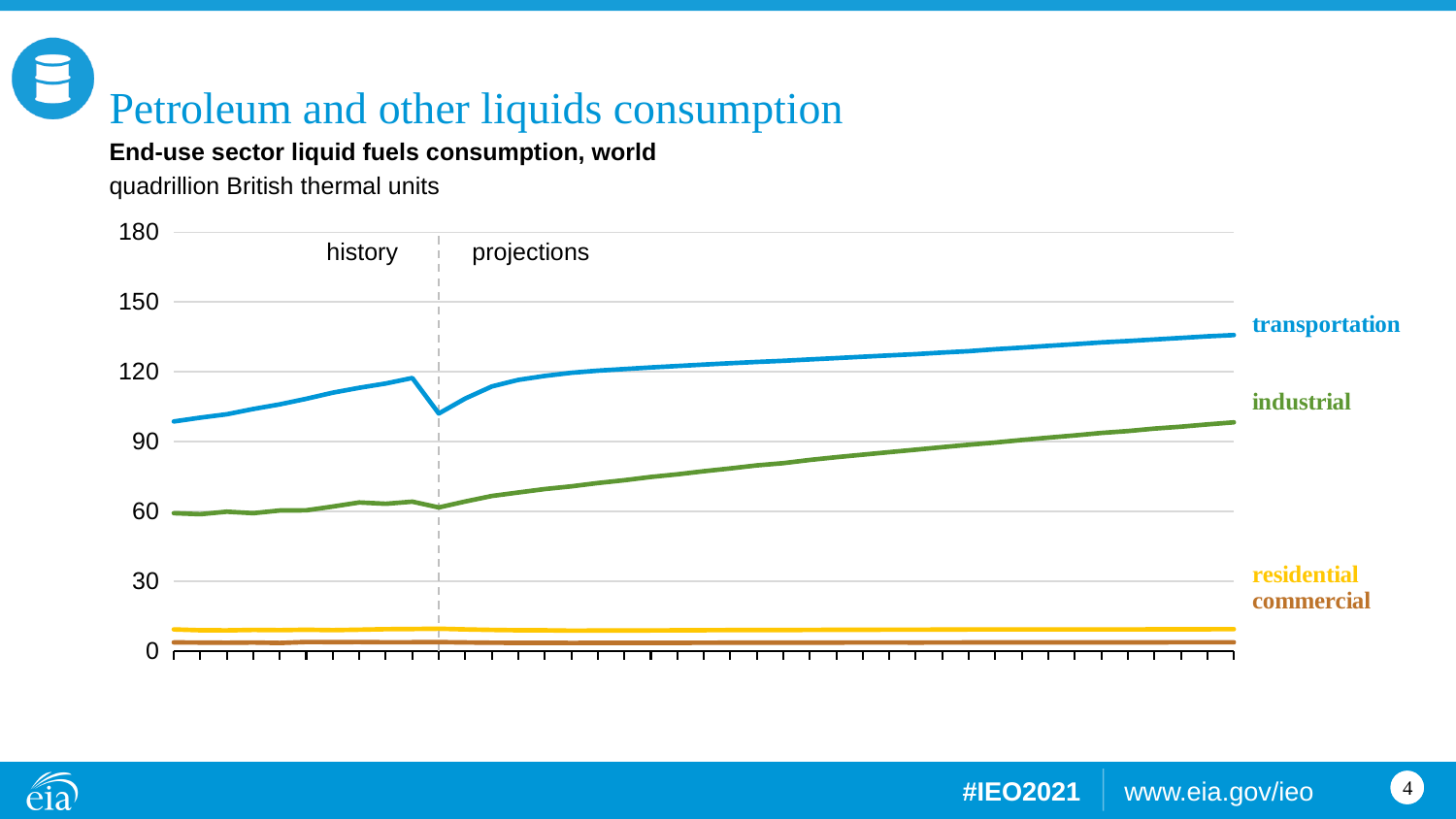
What kind of chart is shown on the slide? line chart At the right end of the chart, is the value for transportation greater or less than 120? greater At the right end of the chart, is the value for industrial greater or less than 90? greater Does the industrial line rise or fall over the projection period? rise How many series are labeled on the chart? 4 At the left end of the chart, is the value for industrial greater or less than 90? less Which sector has the lowest liquid fuels consumption throughout the chart? commercial What two periods does the dashed vertical line separate on the chart? history and projections Which is larger at the right end of the chart, transportation or industrial? transportation Which sector has the highest liquid fuels consumption throughout the chart? transportation What unit is the y axis measured in? quadrillion British thermal units